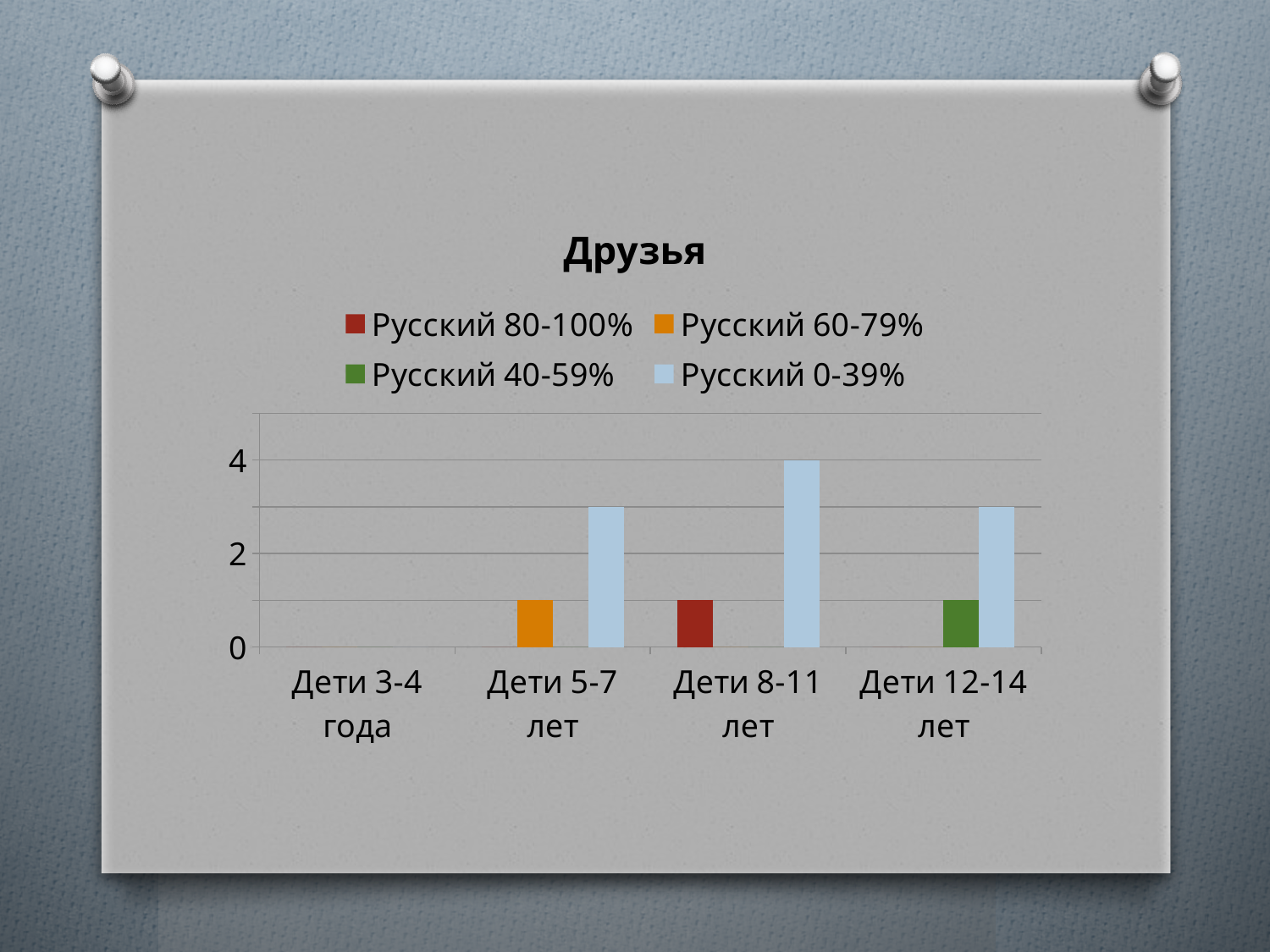
Which colour represents the series Русский 40-59% in the legend? green Which is larger: the Русский 0-39% value for Дети 8-11 лет or for Дети 5-7 лет? Дети 8-11 лет What is the title of the chart? Друзья Is the value for Русский 80-100% in Дети 8-11 лет greater or less than 2? less What is the value for Русский 0-39% in the category Дети 8-11 лет? 4 Is the value for Русский 60-79% in Дети 5-7 лет greater or less than 2? less How many series does the legend list? 4 How many categories are shown on the x axis? 4 Is the value for Русский 0-39% in Дети 5-7 лет greater or less than 2? greater Which category has the highest value for Русский 0-39%? Дети 8-11 лет What type of chart is shown on the slide? bar chart